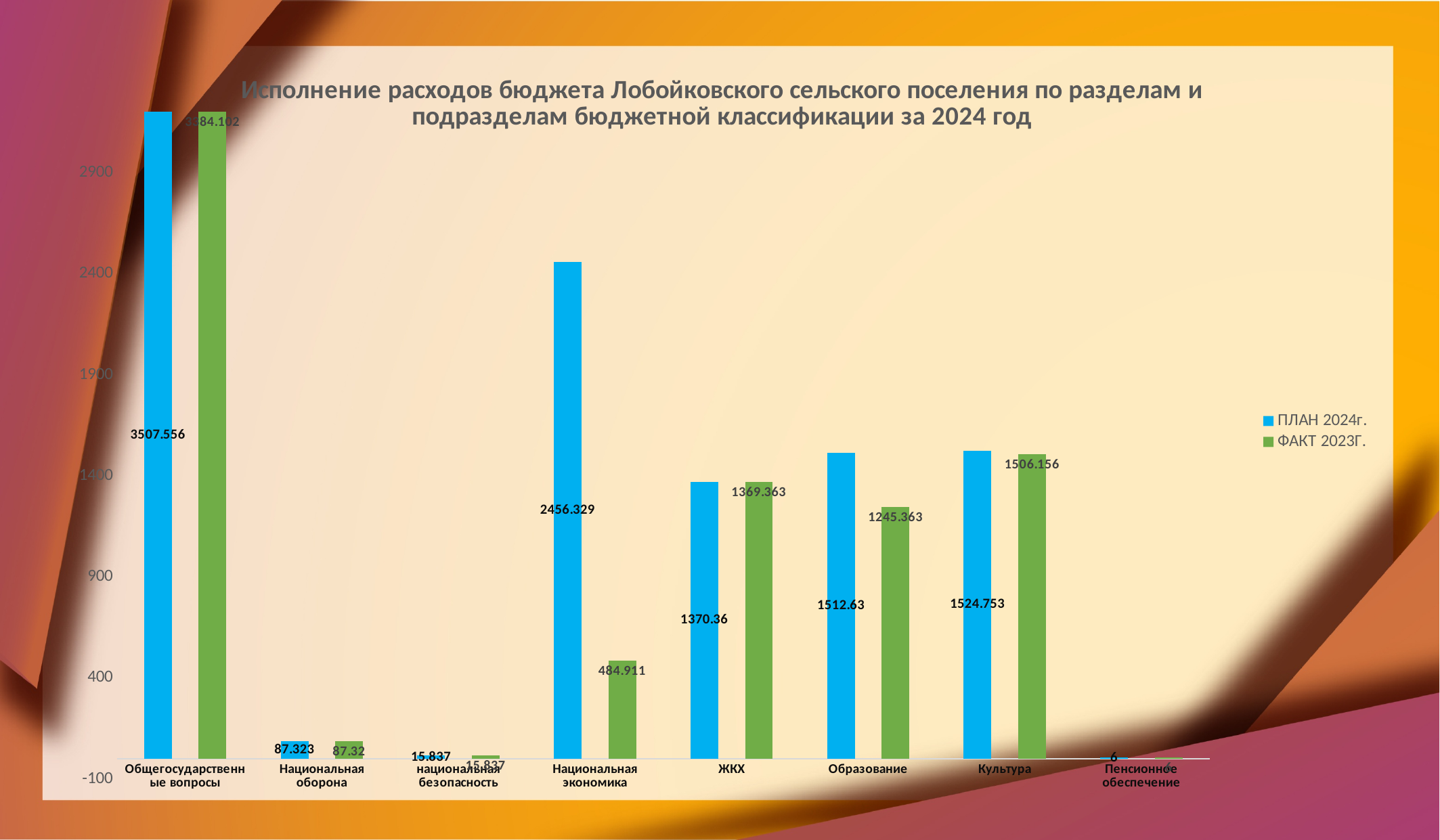
What kind of chart is shown on the slide? Bar chart What is the difference between the ПЛАН 2024г. and ФАКТ 2023Г. values for Национальная экономика? 1971.418 Which category has the highest ПЛАН 2024г. value? Общегосударственные вопросы What is the ФАКТ 2023Г. value for ЖКХ? 1369.363 For Образование, which series is larger: ПЛАН 2024г. or ФАКТ 2023Г.? ПЛАН 2024г. How many series does the legend list? 2 How many categories are shown on the x axis? 8 Which category has the lowest ПЛАН 2024г. value? Пенсионное обеспечение What is the ПЛАН 2024г. value for Национальная экономика? 2456.329 What is the ФАКТ 2023Г. value for Культура? 1506.156 What is the ПЛАН 2024г. value for Образование? 1512.63 What is the ФАКТ 2023Г. value for Национальная экономика? 484.911